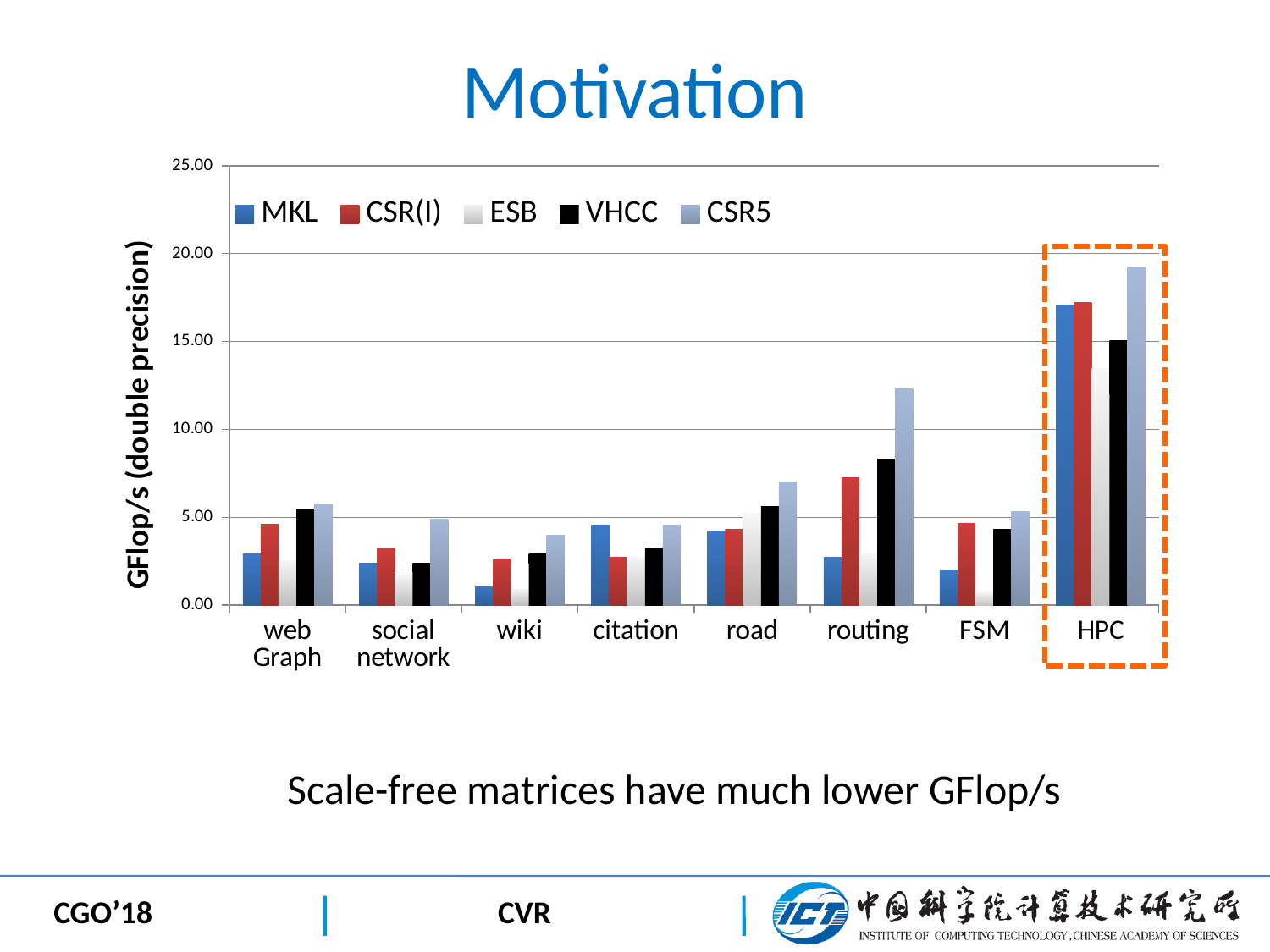
Which category has the lowest MKL value? wiki What is the label of the y axis? GFlop/s (double precision) What kind of chart is shown on the slide? bar chart Is the MKL value for wiki greater or less than 5.00? less How many matrix categories are shown on the x axis? 8 Is the CSR5 value for HPC greater or less than 15.00? greater Is the CSR5 value for routing greater or less than 10.00? greater Which category has the highest CSR5 value? HPC For routing, which is larger: the CSR5 value or the VHCC value? CSR5 For HPC, which is larger: the VHCC value or the ESB value? VHCC How many series does the legend list? 5 Which category is highlighted with a dashed orange box? HPC